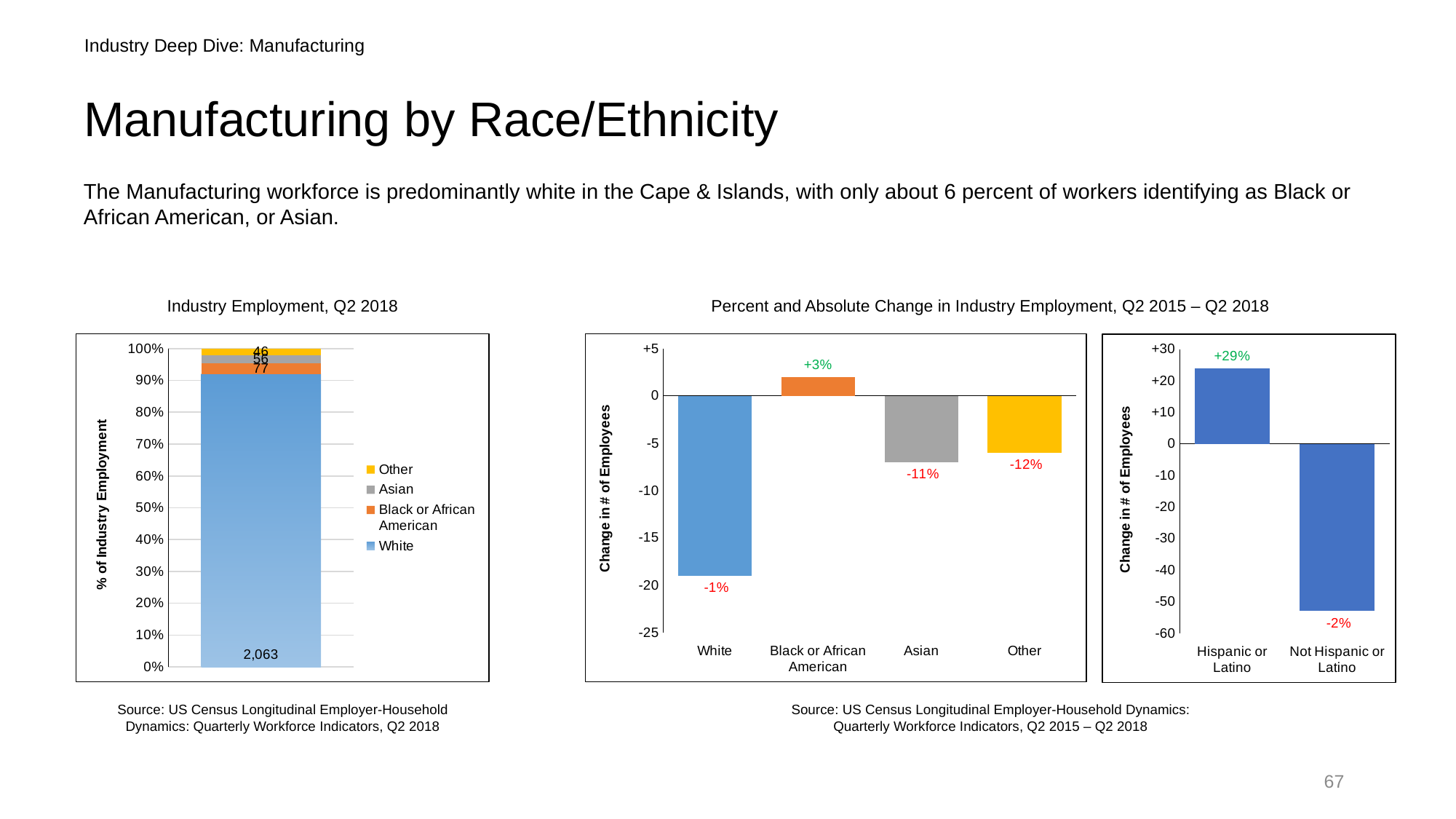
In the Industry Employment, Q2 2018 chart on the left, what is the data label on the Black or African American segment? 77 In the Industry Employment, Q2 2018 chart on the left, what is the data label on the White segment? 2,063 How many series does the legend of the Industry Employment, Q2 2018 chart on the left list? 4 What kind of chart is the Industry Employment, Q2 2018 chart on the left? Stacked bar chart How many categories are shown on the x axis of the middle chart (Percent and Absolute Change in Industry Employment by race)? 4 In the middle chart (Percent and Absolute Change in Industry Employment by race), what percent change is labelled for Asian? -11% In the rightmost chart (change in employment by Hispanic or Latino status), is the change in number of employees for Not Hispanic or Latino greater or less than -40? less In the middle chart (Percent and Absolute Change in Industry Employment by race), what percent change is labelled for Other? -12% In the middle chart (Percent and Absolute Change in Industry Employment by race), which category has the lowest change in number of employees? White In the middle chart (Percent and Absolute Change in Industry Employment by race), which category is the only one with a positive change in number of employees? Black or African American In the rightmost chart (change in employment by Hispanic or Latino status), what percent change is labelled for Hispanic or Latino? +29% In the middle chart (Percent and Absolute Change in Industry Employment by race), is the change in number of employees for White greater or less than -15? less